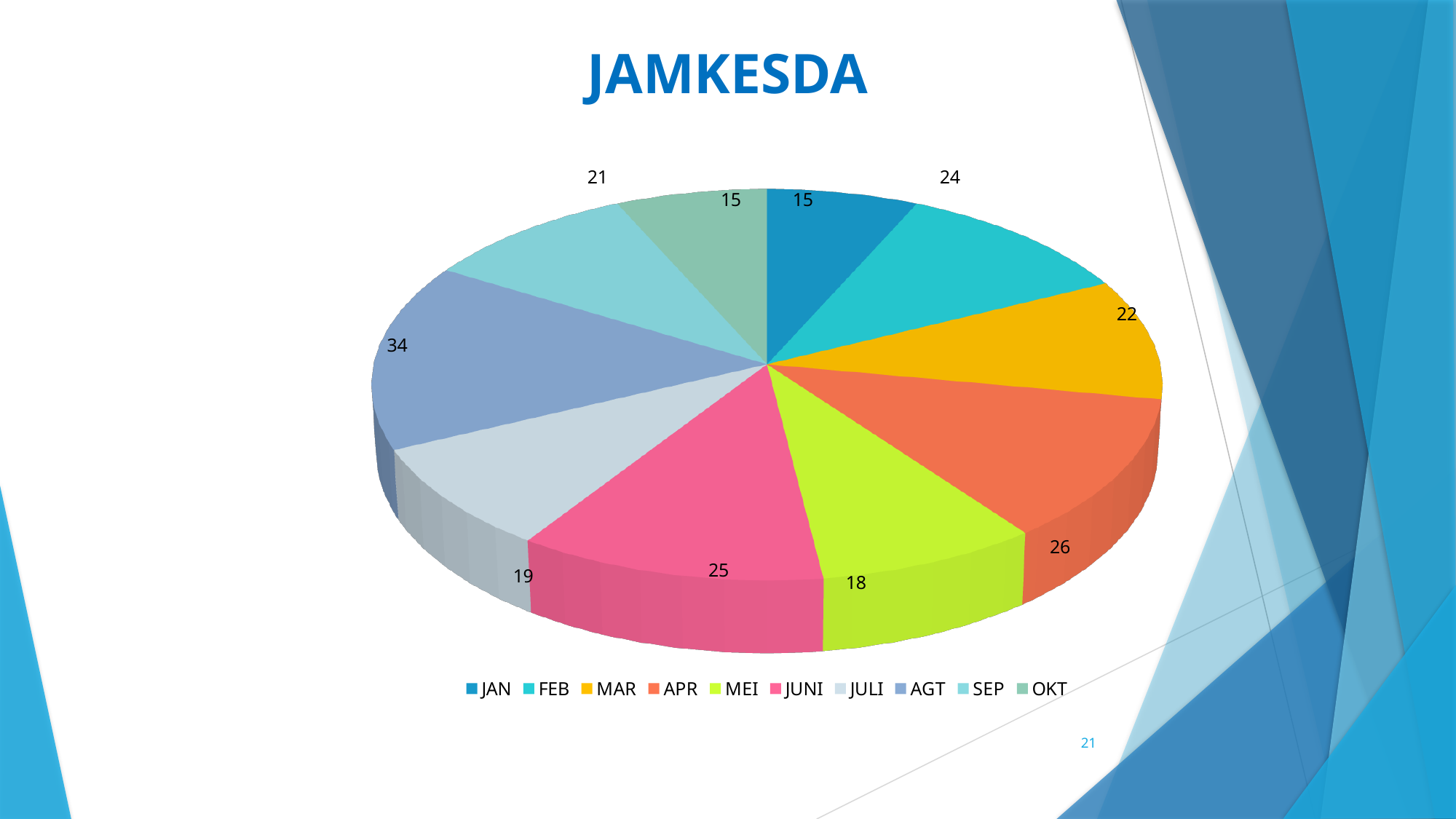
What is the difference between the values for APR and MEI? 8 What is the value for JULI in the pie chart? 19 What is the title of the slide containing the chart? JAMKESDA What is the difference between the values for AGT and JAN? 19 Which is larger, the value for JUNI or the value for APR? APR What is the value for APR in the pie chart? 26 Which is larger, the value for FEB or the value for MAR? FEB What kind of chart is shown on the slide? Pie chart Which month has the largest slice in the pie chart? AGT How many categories does the pie chart show? 10 What is the value for SEP in the pie chart? 21 What is the value for AGT in the pie chart? 34